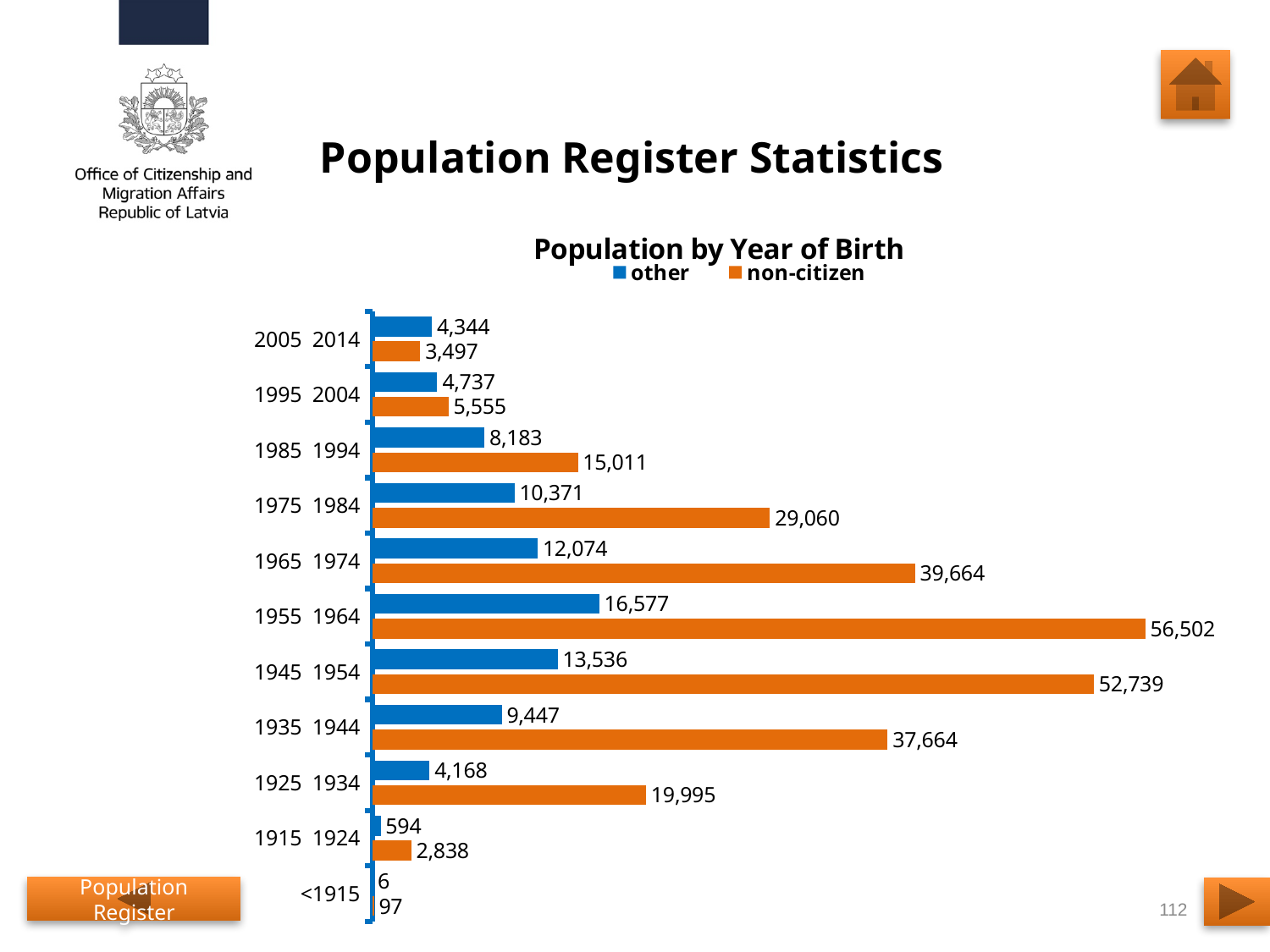
What is the difference between the non-citizen and 'other' values for the 1945–1954 group? 39,203 Which birth-year group has the lowest 'other' value? <1915 How many birth-year groups are shown on the chart? 11 What is the total of the 'other' and non-citizen values for the 1915–1924 group? 3,432 For the 2005–2014 group, which is larger: the 'other' value or the non-citizen value? other What colour represents the non-citizen series in the chart? orange Which birth-year group has the highest non-citizen value? 1955 1964 How many series does the legend list? 2 What is the non-citizen value for the 1955–1964 birth-year group? 56,502 What kind of chart is shown on the slide? bar chart What is the non-citizen value for the <1915 birth-year group? 97 What is the 'other' value for the 1975–1984 birth-year group? 10,371